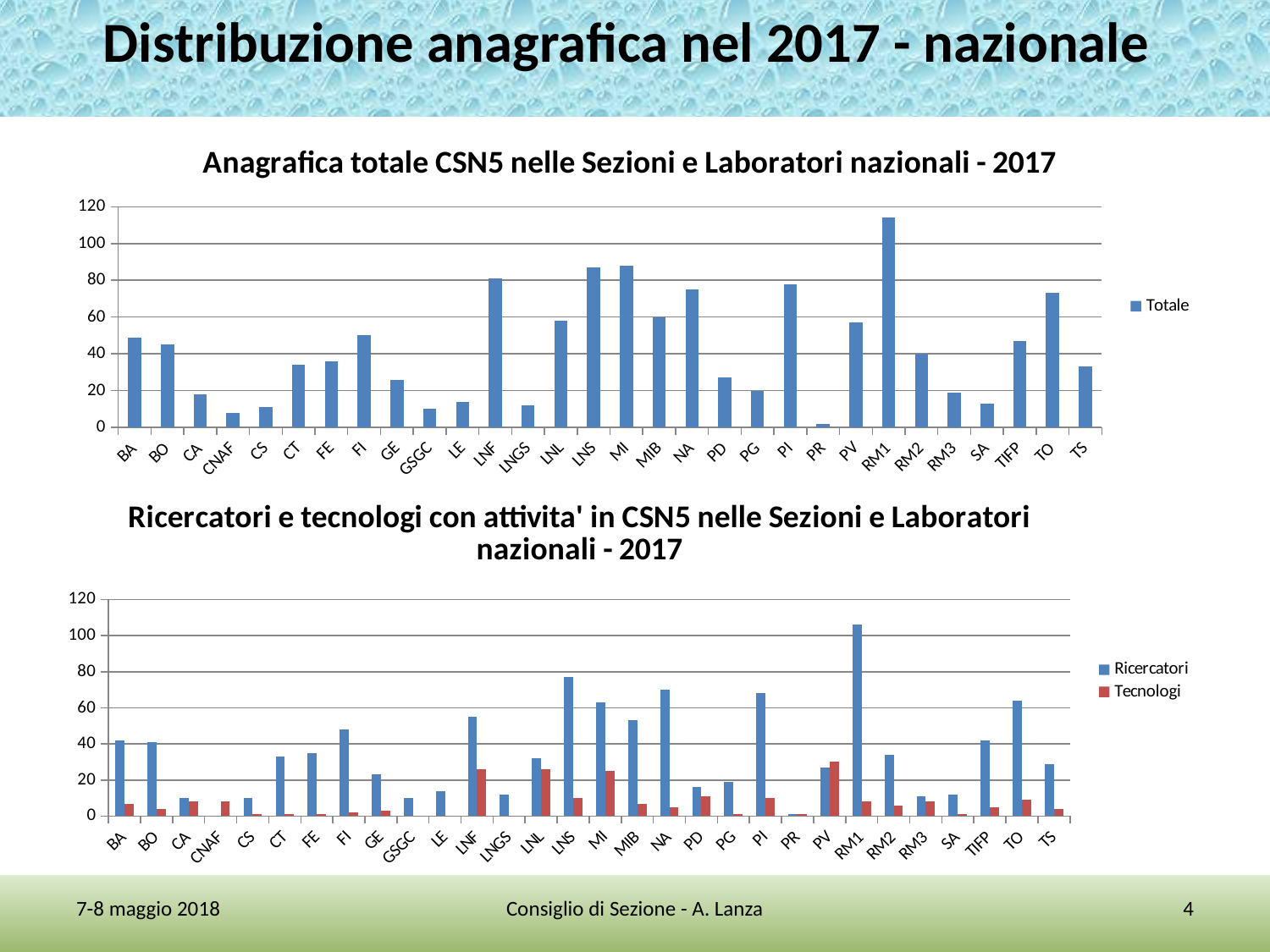
What type of chart is the bottom chart (Ricercatori e tecnologi)? bar chart How many series does the legend of the bottom chart (Ricercatori e tecnologi) list? 2 In the top chart (Anagrafica totale CSN5), which category has the lowest value? PR In the bottom chart (Ricercatori e tecnologi), is the Ricercatori value for LNS greater or less than 60? greater In the top chart (Anagrafica totale CSN5), which category has the highest value? RM1 In the top chart (Anagrafica totale CSN5), is the value for RM1 greater or less than 100? greater In the bottom chart (Ricercatori e tecnologi), which category has the highest Ricercatori value? RM1 In the top chart (Anagrafica totale CSN5), which is larger, the value for LNS or the value for LNL? LNS In the bottom chart (Ricercatori e tecnologi), which category has the highest Tecnologi value? PV In the top chart (Anagrafica totale CSN5), is the value for TO greater or less than 60? greater How many categories are shown on the x axis of the top chart (Anagrafica totale CSN5)? 30